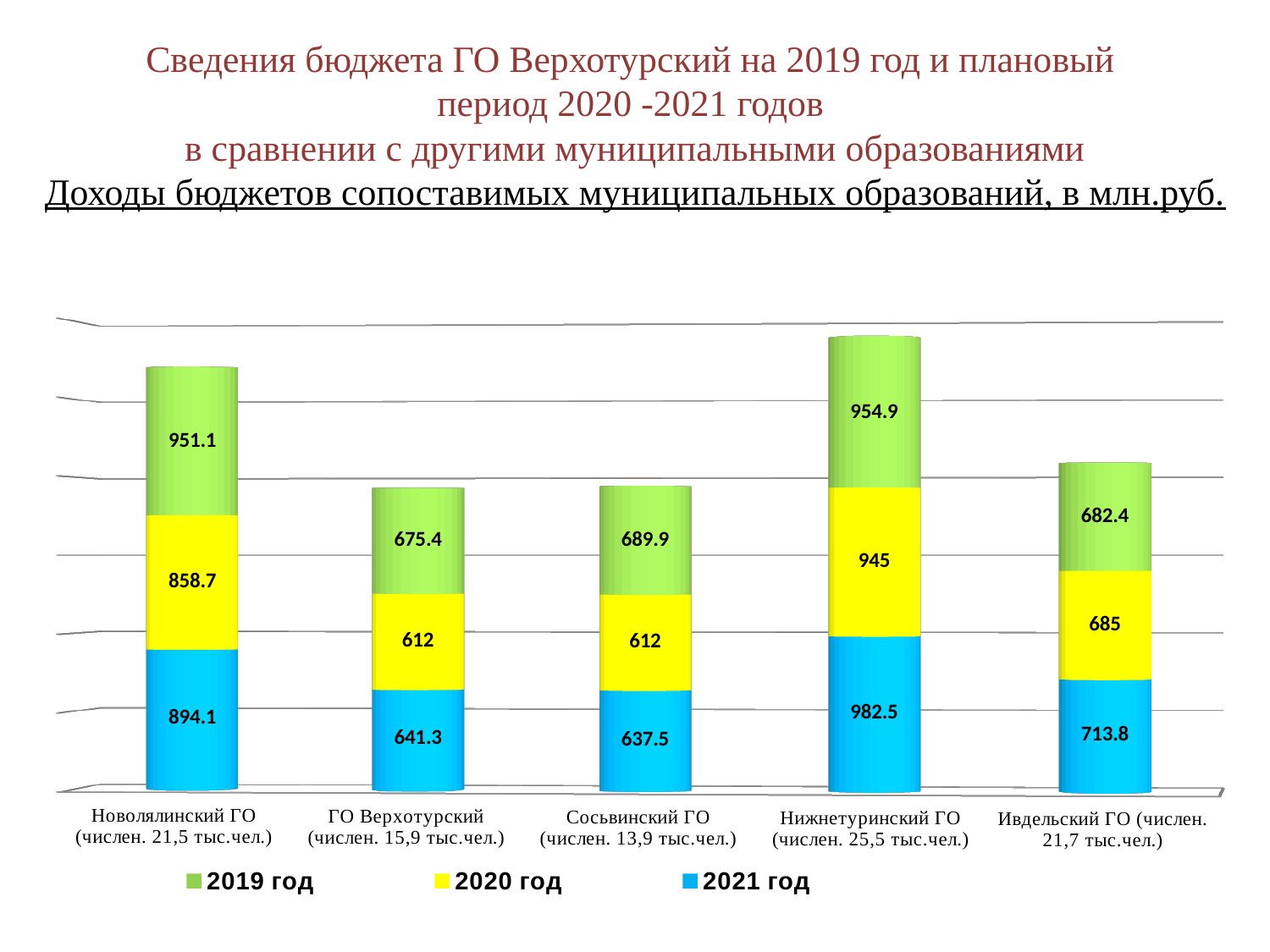
Which municipality has the highest 2021 год value? Нижнетуринский ГО Which is larger: the 2021 год value for Сосьвинский ГО or for Ивдельский ГО? Ивдельский ГО What is the difference between the 2019 год values of Новолялинский ГО and ГО Верхотурский? 275.7 How many municipalities are shown on the x axis? 5 What is the 2020 год value for Ивдельский ГО? 685 What is the 2021 год value for ГО Верхотурский? 641.3 Which municipality has the lowest 2019 год value? ГО Верхотурский What kind of chart is shown on the slide? Stacked bar chart How many series does the legend list? 3 What is the total of the stacked bar for ГО Верхотурский? 1928.7 Which colour represents 2020 год in the legend? Yellow What is the 2019 год value for Нижнетуринский ГО? 954.9